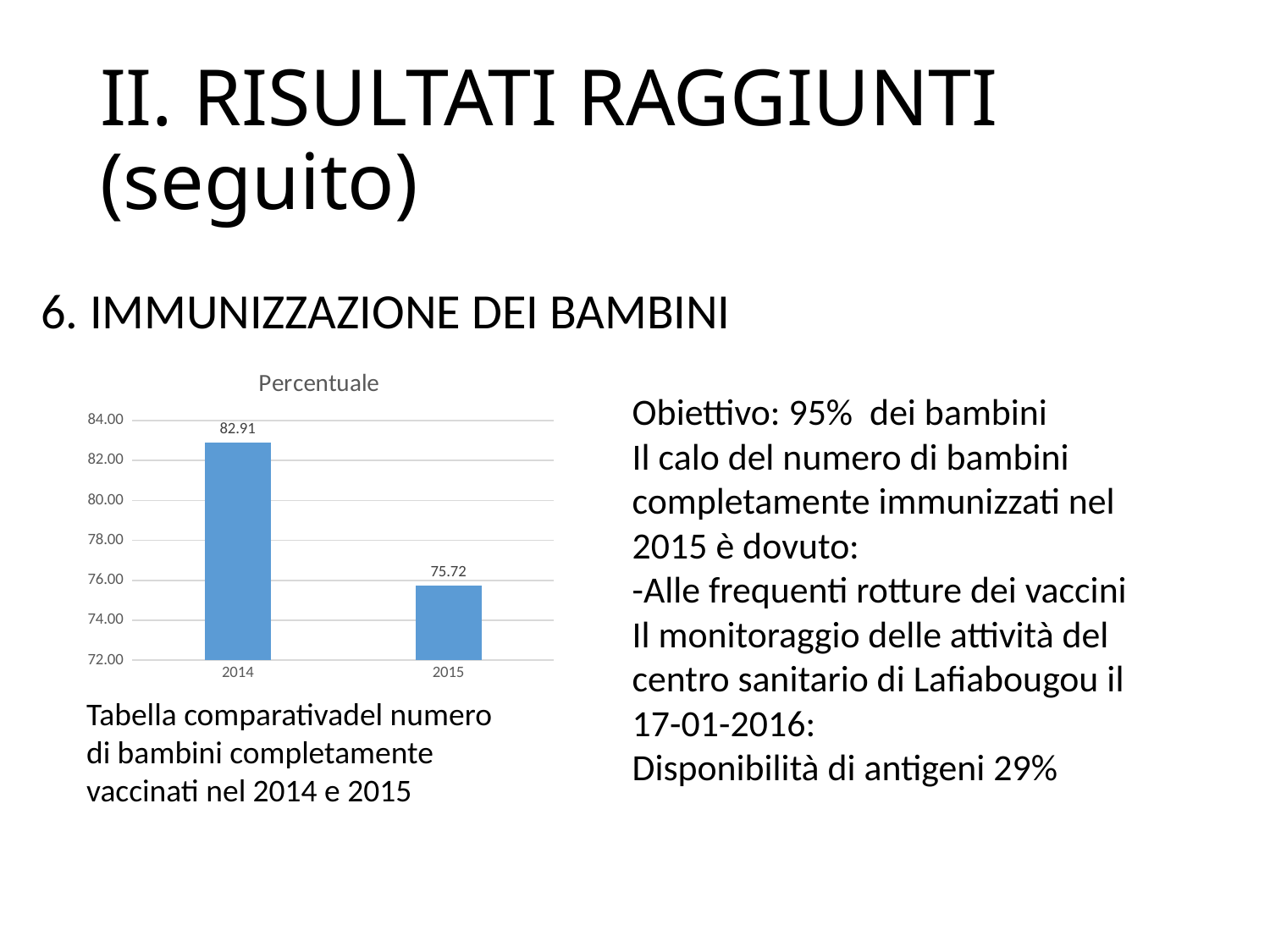
Do the values in the Percentuale chart rise or fall from 2014 to 2015? fall Which year has the lowest value in the Percentuale chart? 2015 What is the value for 2015 in the Percentuale chart? 75.72 What is the value for 2014 in the Percentuale chart? 82.91 How many categories are shown on the x axis of the Percentuale chart? 2 Which year has the highest value in the Percentuale chart? 2014 Which is larger in the Percentuale chart, the value for 2014 or for 2015? 2014 Is the value for 2014 in the Percentuale chart greater or less than 80.00? greater What is the difference between the 2014 and 2015 values in the Percentuale chart? 7.19 What is the title of the chart on the slide? Percentuale What kind of chart is the Percentuale chart? bar chart Is the value for 2015 in the Percentuale chart greater or less than 78.00? less